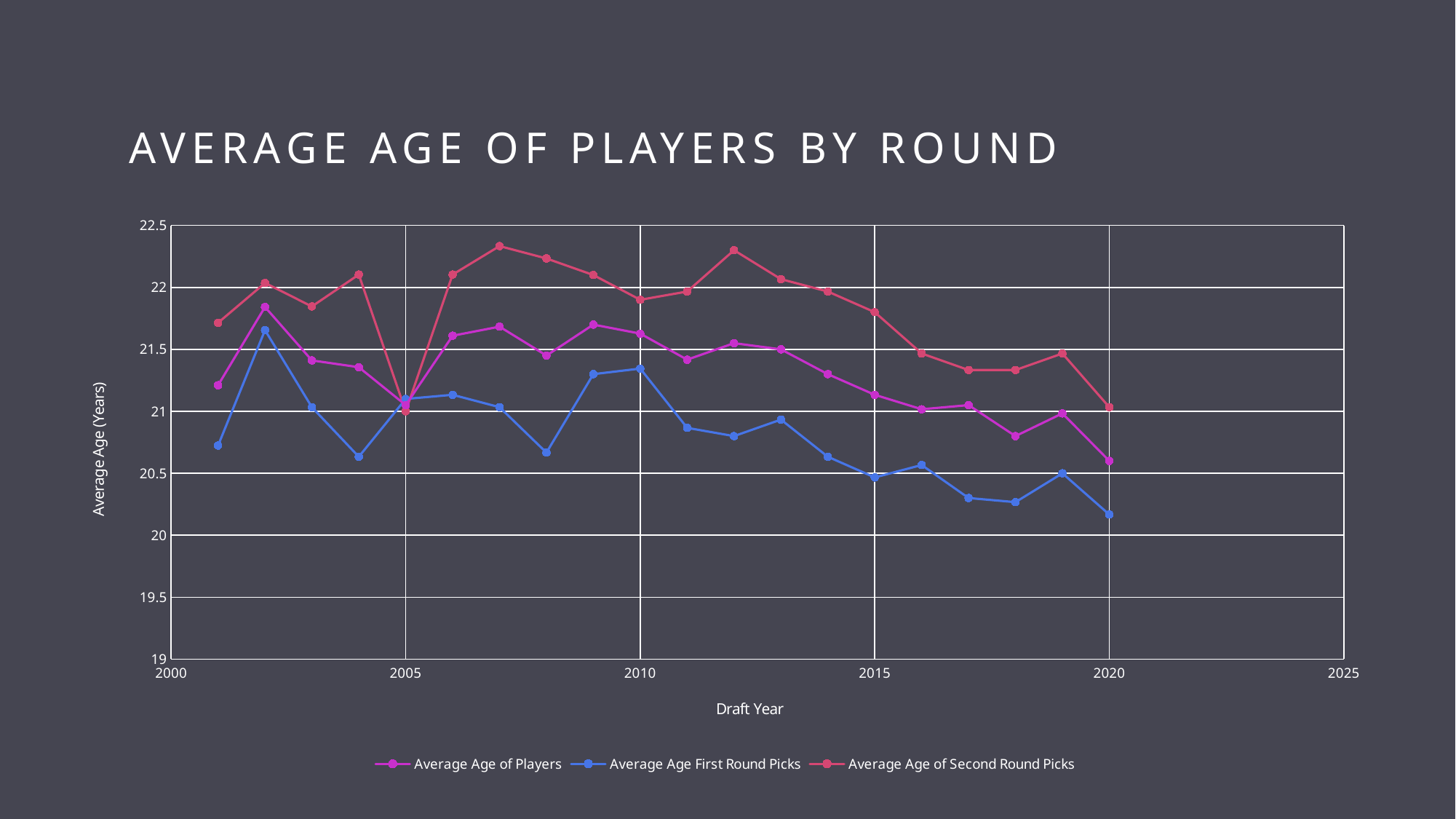
Is the value for Average Age First Round Picks in 2020 greater or less than 20.5? less In which draft year is the Average Age First Round Picks series at its lowest? 2020 How many series does the legend list? 3 In which draft year is the Average Age First Round Picks series at its highest? 2002 What is the title of the chart? Average Age of Players by Round In 2010, which is larger: Average Age First Round Picks or Average Age of Second Round Picks? Average Age of Second Round Picks Is the value for Average Age of Second Round Picks in 2007 greater or less than 22? greater Is the value for Average Age of Players in 2002 greater or less than 21.5? greater What kind of chart is shown on the slide? Line chart Does the Average Age First Round Picks series generally rise or fall from 2010 to 2020? Fall What is the label of the vertical axis? Average Age (Years)